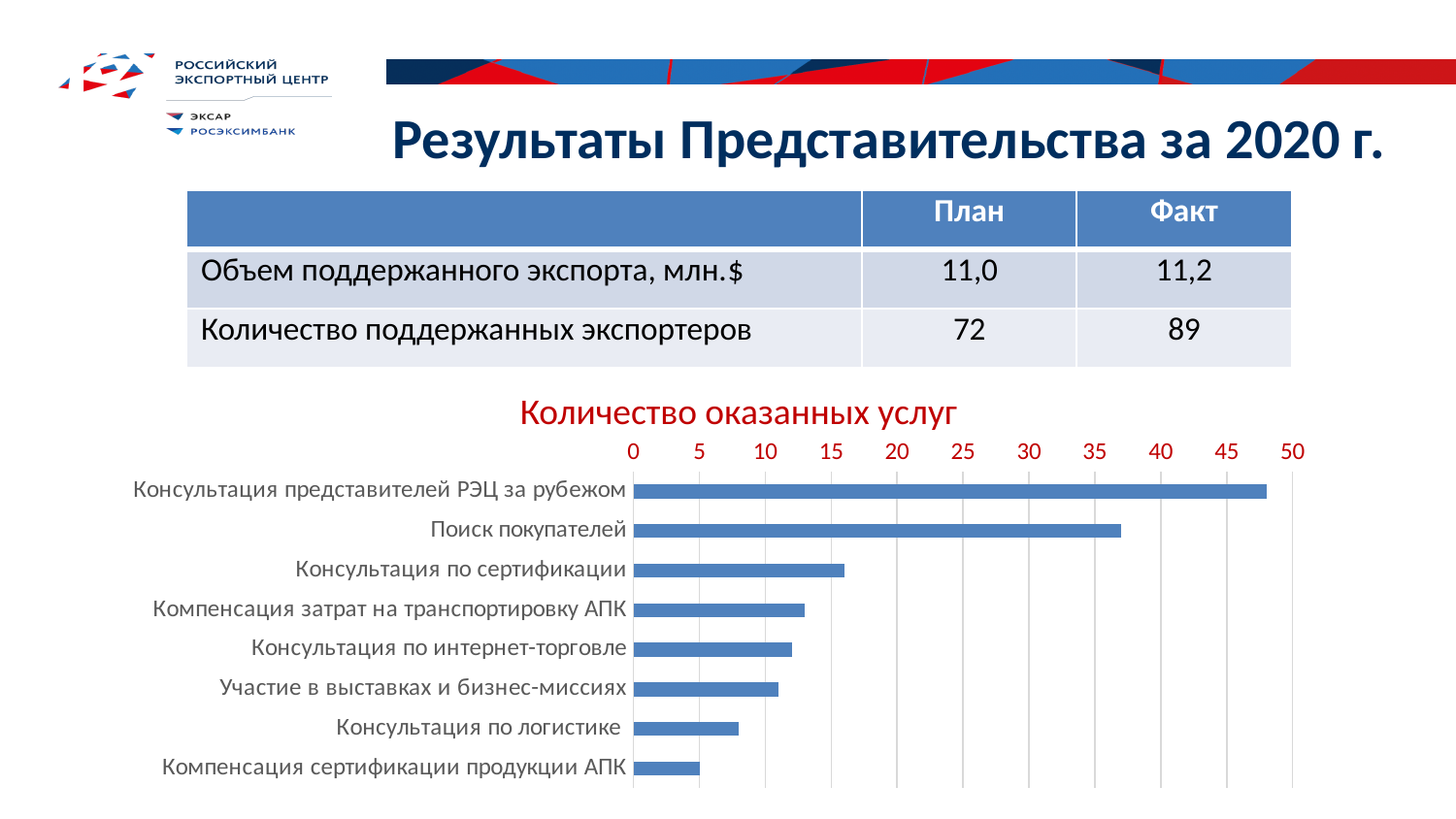
What is the title of the bar chart on the slide? Количество оказанных услуг How many categories are plotted in the "Количество оказанных услуг" chart? 8 What kind of chart is shown under the heading "Количество оказанных услуг"? bar chart Which category has the highest value in the "Количество оказанных услуг" chart? Консультация представителей РЭЦ за рубежом Which is larger: the value for "Поиск покупателей" or the value for "Консультация по сертификации"? Поиск покупателей Is the value for "Консультация по логистике" greater or less than 10? less What is the maximum value shown on the horizontal axis of the "Количество оказанных услуг" chart? 50 Is the value for "Поиск покупателей" greater or less than 40? less Is the value for "Консультация представителей РЭЦ за рубежом" greater or less than 45? greater Which category has the lowest value in the "Количество оказанных услуг" chart? Компенсация сертификации продукции АПК Which is larger: the value for "Консультация по логистике" or the value for "Компенсация затрат на транспортировку АПК"? Компенсация затрат на транспортировку АПК